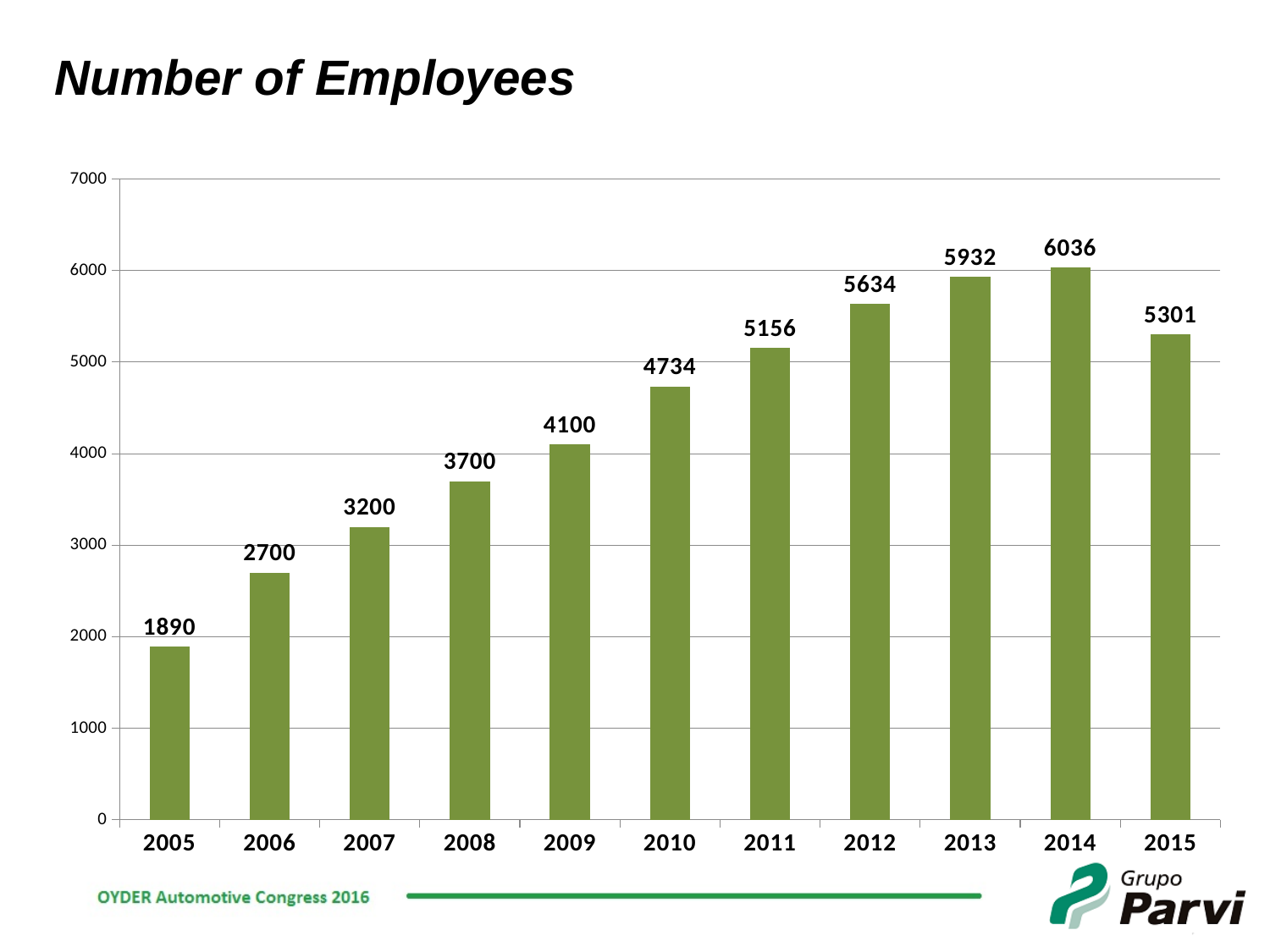
Which year has the highest number of employees? 2014 How many years are shown on the chart? 11 Which year has more employees, 2012 or 2013? 2013 What is the difference in the number of employees between 2014 and 2015? 735 Is the number of employees in 2011 greater or less than 5000? greater What is the title of the chart? Number of Employees What is the number of employees in 2010? 4734 What is the number of employees in 2015? 5301 What is the number of employees in 2005? 1890 What kind of chart is shown on the slide? bar chart Which year has the lowest number of employees? 2005 What is the difference in the number of employees between 2006 and 2005? 810